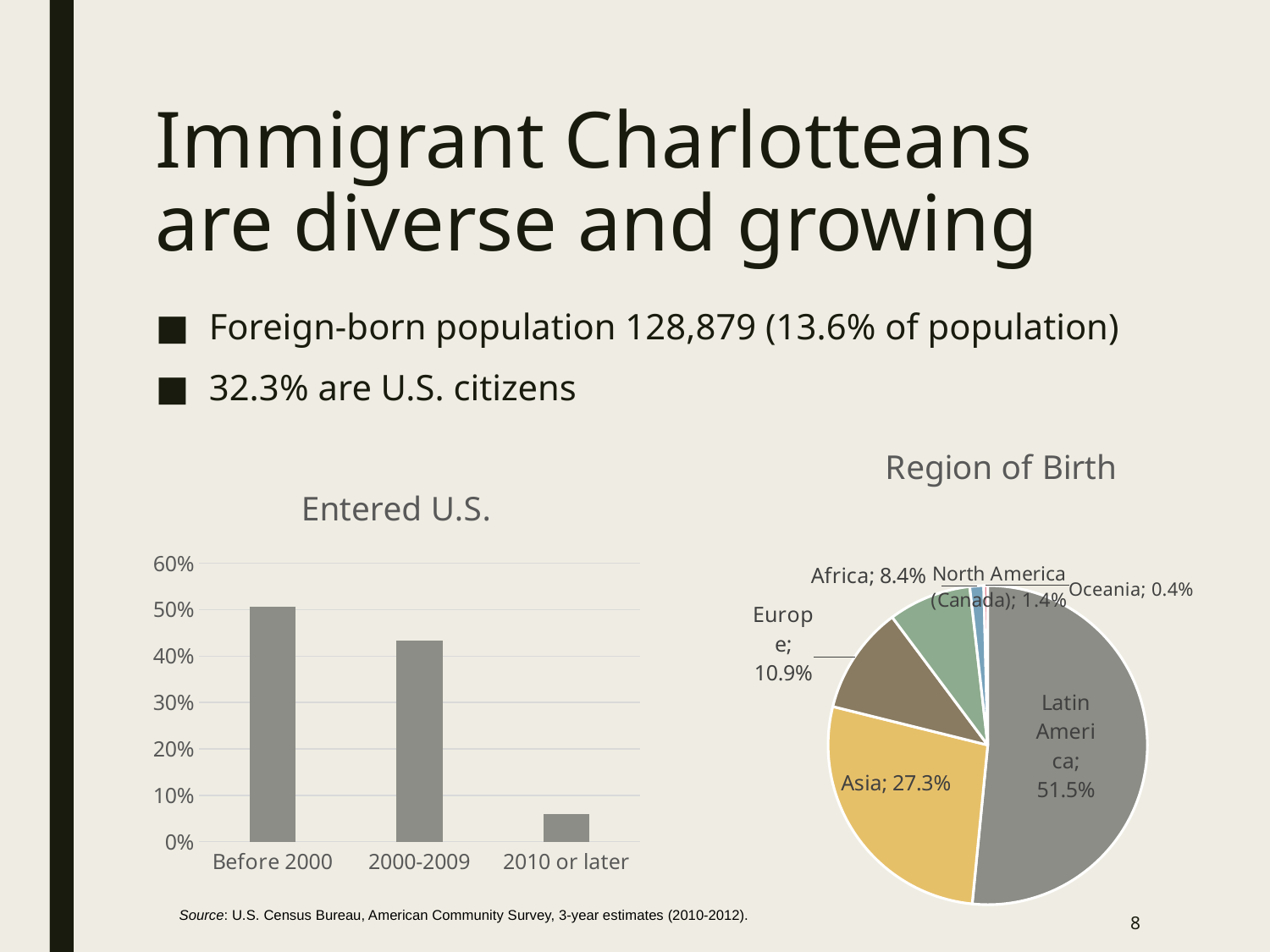
In the 'Region of Birth' chart, what share is Asia? 27.3% In the 'Region of Birth' chart, what is the difference between the Europe and Africa shares? 2.5% In the 'Entered U.S.' chart, which period has the highest bar? Before 2000 In the 'Entered U.S.' chart, is the value for '2000-2009' greater or less than 40%? greater In the 'Entered U.S.' chart, is the value for '2010 or later' greater or less than 10%? less In the 'Entered U.S.' chart, how many periods are shown on the x axis? 3 In the 'Entered U.S.' chart, which period has the lowest bar? 2010 or later In the 'Region of Birth' chart, which region has the smallest slice? Oceania In the 'Region of Birth' chart, what share is Latin America? 51.5% In the 'Entered U.S.' chart, do the values rise or fall from 'Before 2000' to '2010 or later'? Fall What kind of chart is the 'Entered U.S.' chart? Bar chart